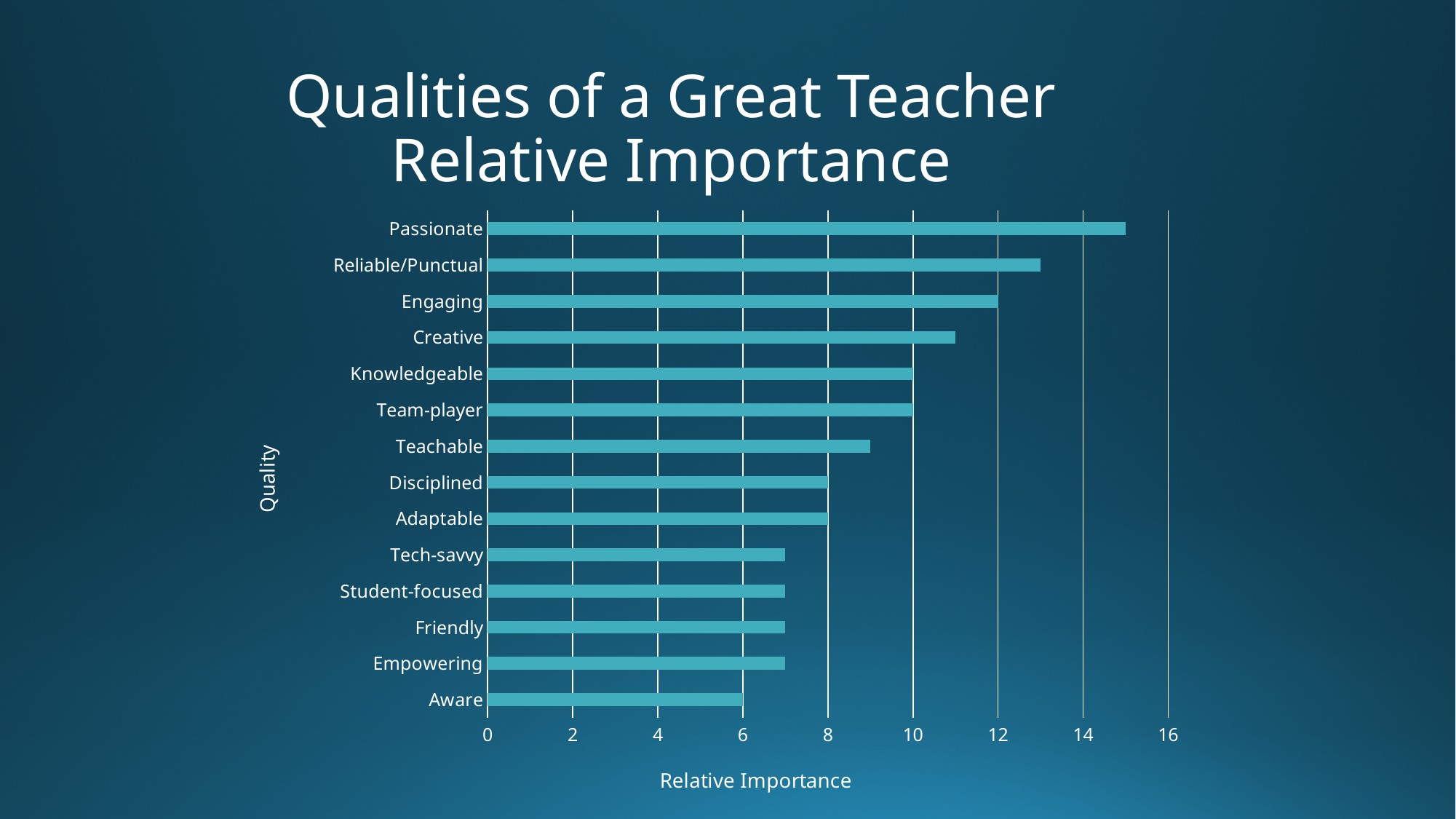
What is the difference between the values for Engaging and Aware? 6 What is the relative importance value for Engaging? 12 Is the value for Teachable greater or less than 10? less What is the relative importance value for Aware? 6 Which quality has the highest relative importance? Passionate Is the value for Passionate greater or less than 14? greater How many qualities are plotted on the chart? 14 Is the value for Reliable/Punctual greater or less than 12? greater What kind of chart is shown on the slide? bar chart What is the label on the horizontal axis? Relative Importance Which quality has the lowest relative importance? Aware What is the relative importance value for Disciplined? 8